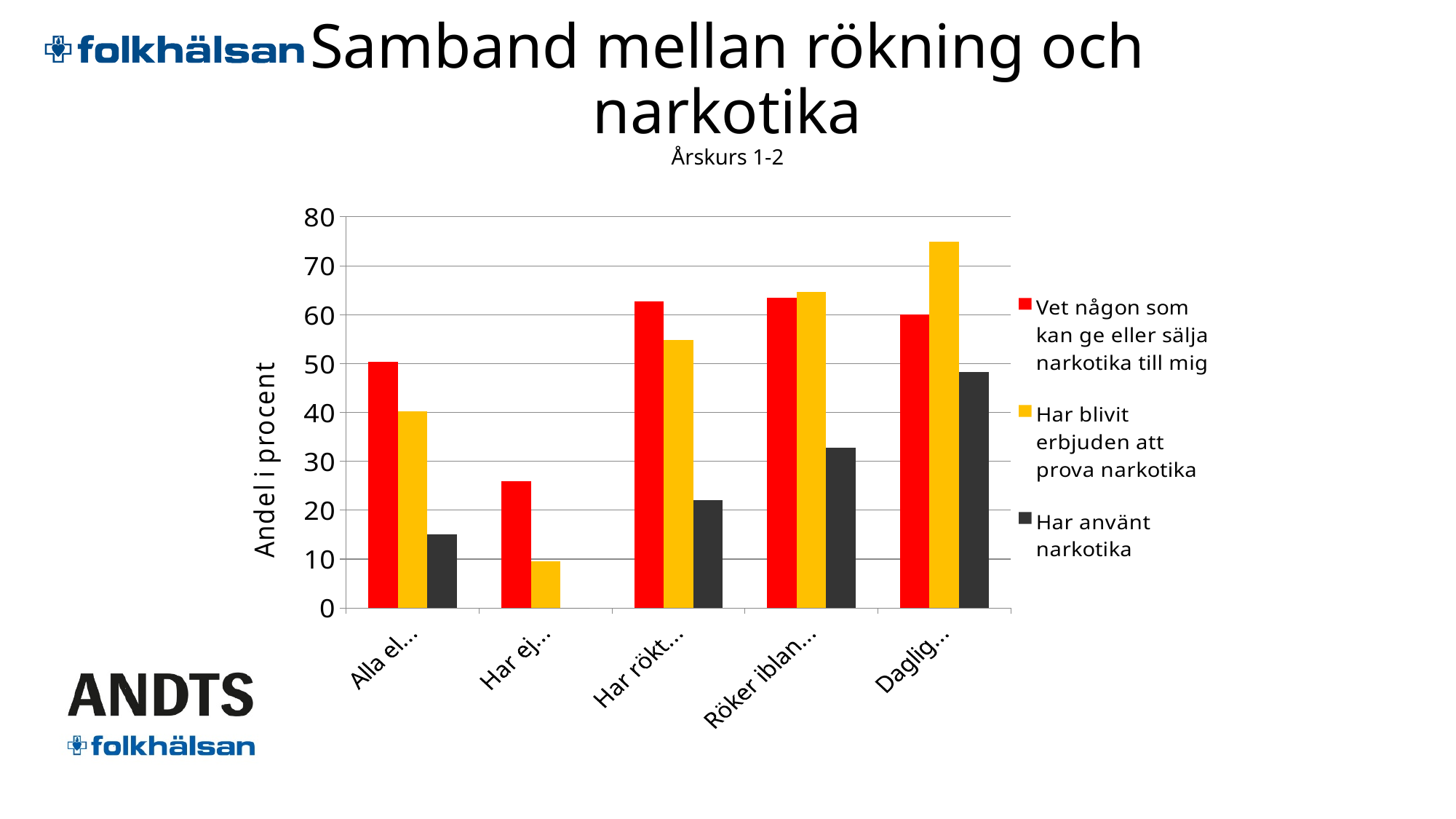
Which category has the lowest value for the 'Vet någon som kan ge eller sälja narkotika till mig' series? Har ej... For 'Alla el...', which is larger: 'Vet någon som kan ge eller sälja narkotika till mig' or 'Har använt narkotika'? Vet någon som kan ge eller sälja narkotika till mig Which category has the highest value for the 'Har använt narkotika' series? Daglig... For 'Daglig...', which is larger: 'Vet någon som kan ge eller sälja narkotika till mig' or 'Har blivit erbjuden att prova narkotika'? Har blivit erbjuden att prova narkotika How many categories are shown on the x axis? 5 How many series does the legend list? 3 Is the 'Har blivit erbjuden att prova narkotika' value for 'Daglig...' greater or less than 70? greater What kind of chart is shown on the slide? bar chart What is the label of the y axis? Andel i procent Is the 'Vet någon som kan ge eller sälja narkotika till mig' value for 'Har rökt...' greater or less than 60? greater Which category has the highest value for the 'Har blivit erbjuden att prova narkotika' series? Daglig...